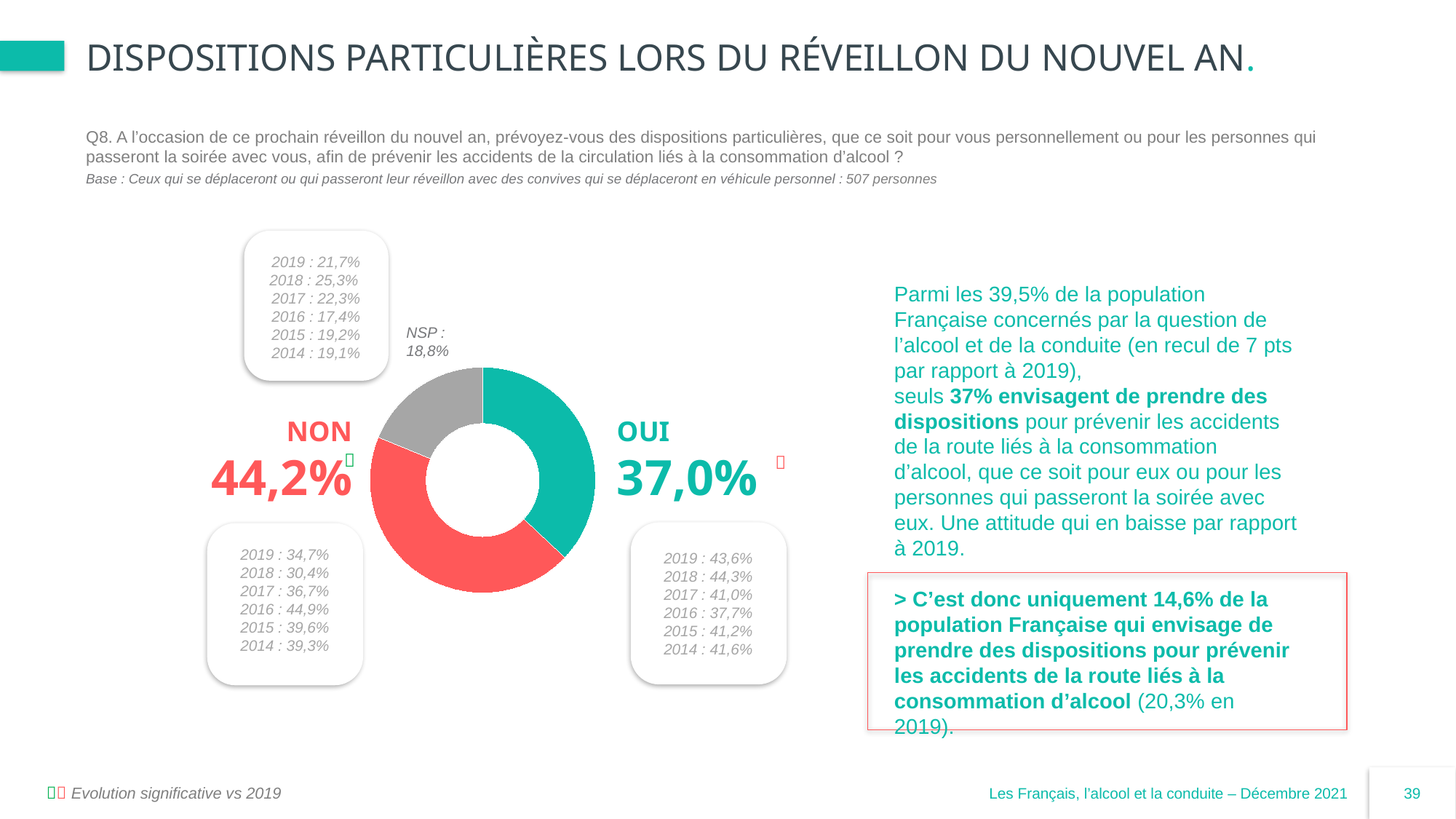
What colour is the OUI slice in the donut chart? Teal (green) Which category has the smallest share of the donut chart? NSP According to the box next to NON, what was the NON value in 2016? 44,9% Which is larger, the share for NON or the share for OUI? NON What is the value for OUI in the donut chart? 37,0% According to the box next to OUI, what was the OUI value in 2019? 43,6% What is the value for NON in the donut chart? 44,2% What is the difference between the NON share and the OUI share? 7,2 points How many slices does the donut chart have? 3 What kind of chart is shown on the slide? Donut (pie) chart What is the value for NSP in the donut chart? 18,8% Which category has the largest share of the donut chart? NON